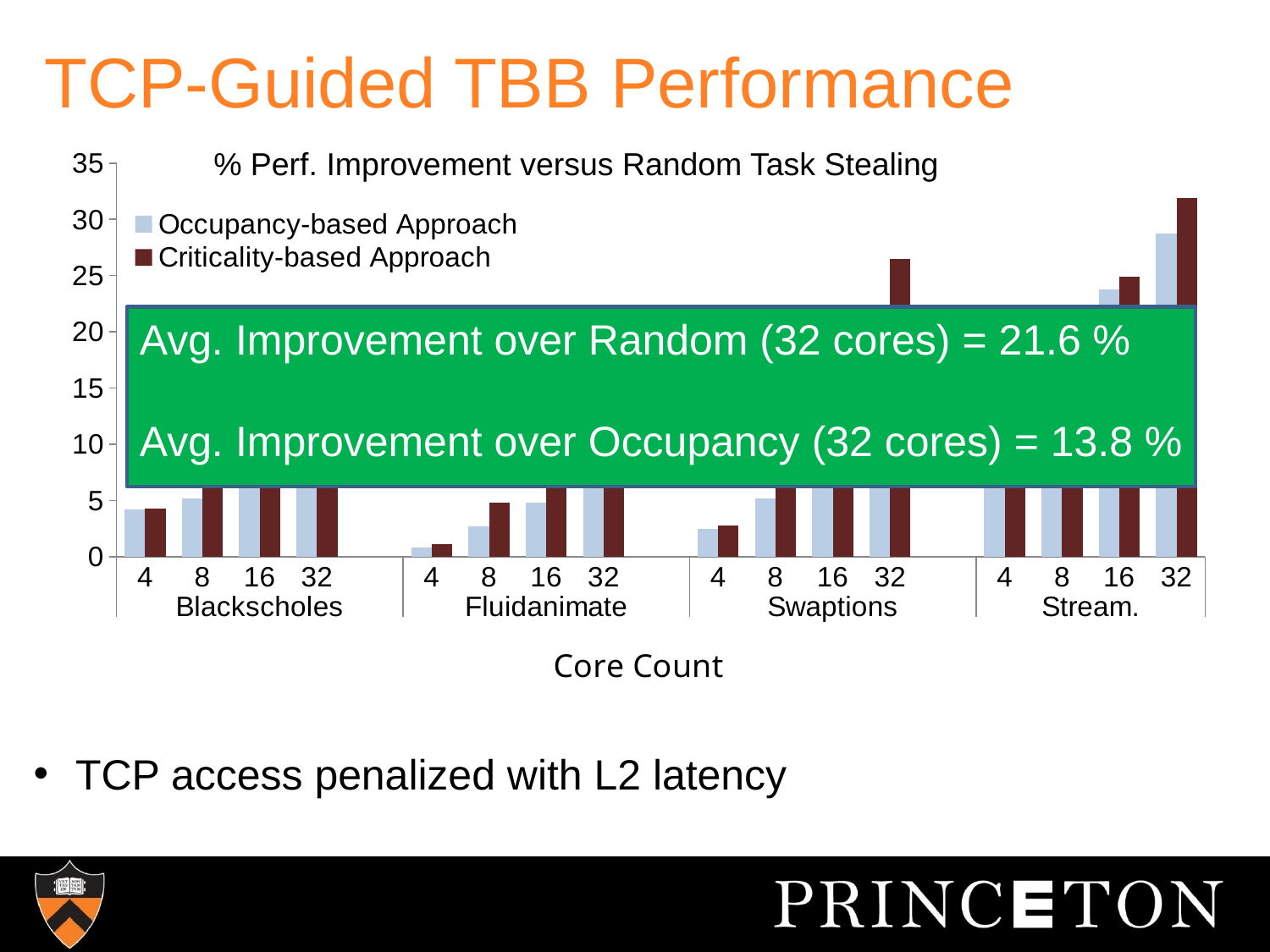
For Fluidanimate at 8 cores, which series has the larger value, Occupancy-based Approach or Criticality-based Approach? Criticality-based Approach Is the Criticality-based Approach value for Swaptions at 32 cores greater or less than 25? greater How many series does the chart legend list? 2 Is the Occupancy-based Approach value for Stream. at 32 cores greater or less than 30? less How many core-count groups are plotted in total across all benchmarks? 16 Is the Occupancy-based Approach value for Fluidanimate at 4 cores greater or less than 5? less Which bar is the highest in the chart? Criticality-based Approach, Stream. at 32 cores How many benchmarks are shown along the x axis of the chart? 4 What is the label of the x axis? Core Count What is the title of the chart? % Perf. Improvement versus Random Task Stealing What kind of chart is shown on the slide? bar chart